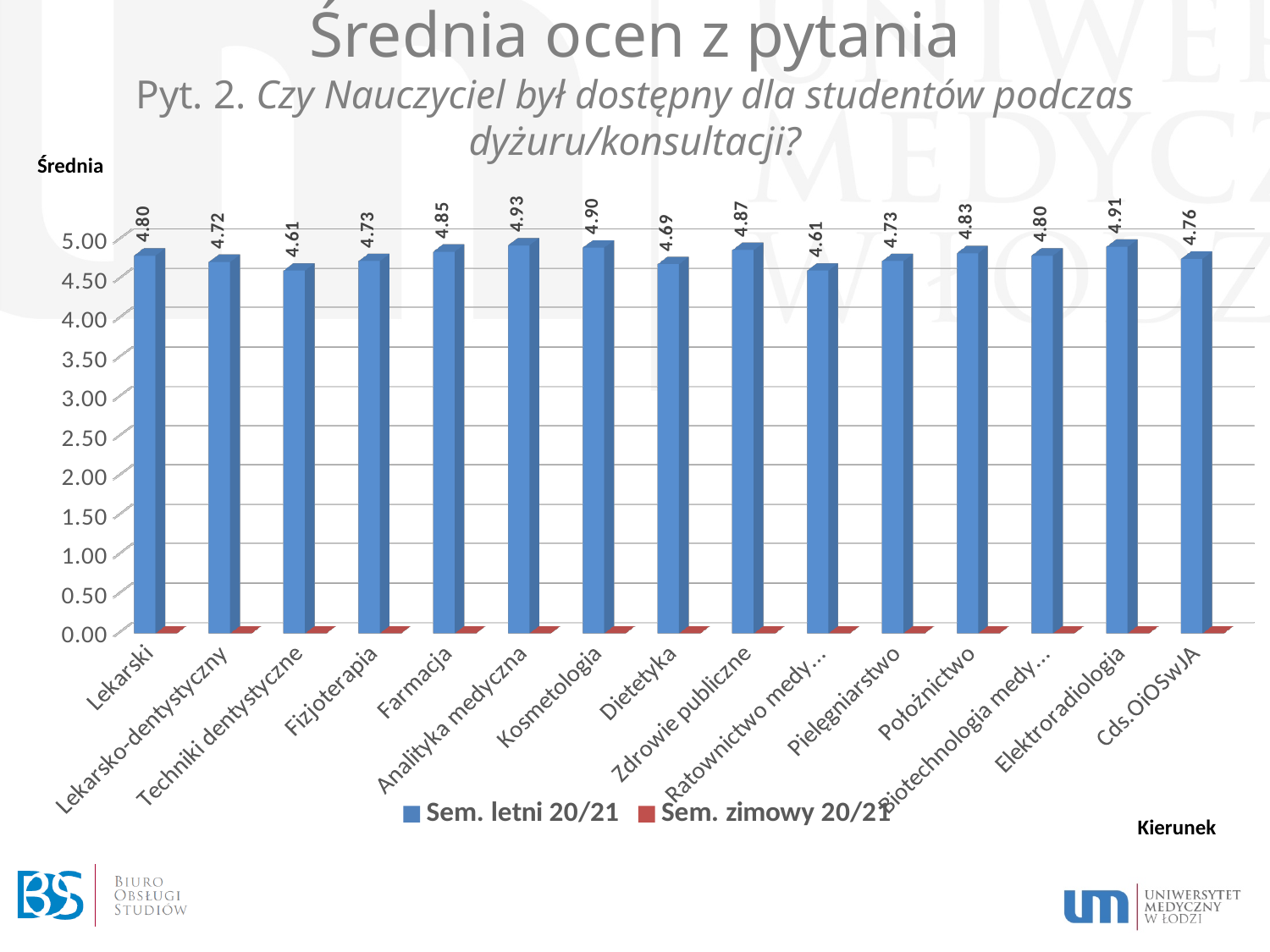
Which is larger, the value for Zdrowie publiczne or the value for Położnictwo? Zdrowie publiczne How many categories are shown on the x axis? 15 Which category has the highest value? Analityka medyczna What is the value for Lekarski in the Sem. letni 20/21 series? 4.80 What is the value for Farmacja? 4.85 What is the value for Elektroradiologia? 4.91 What is the value for Dietetyka? 4.69 Is the value for Pielęgniarstwo greater or less than 4.50? greater What is the value for Kosmetologia? 4.90 What kind of chart is shown on the slide? bar chart What is the difference between the values for Analityka medyczna and Dietetyka? 0.24 How many series does the legend list? 2